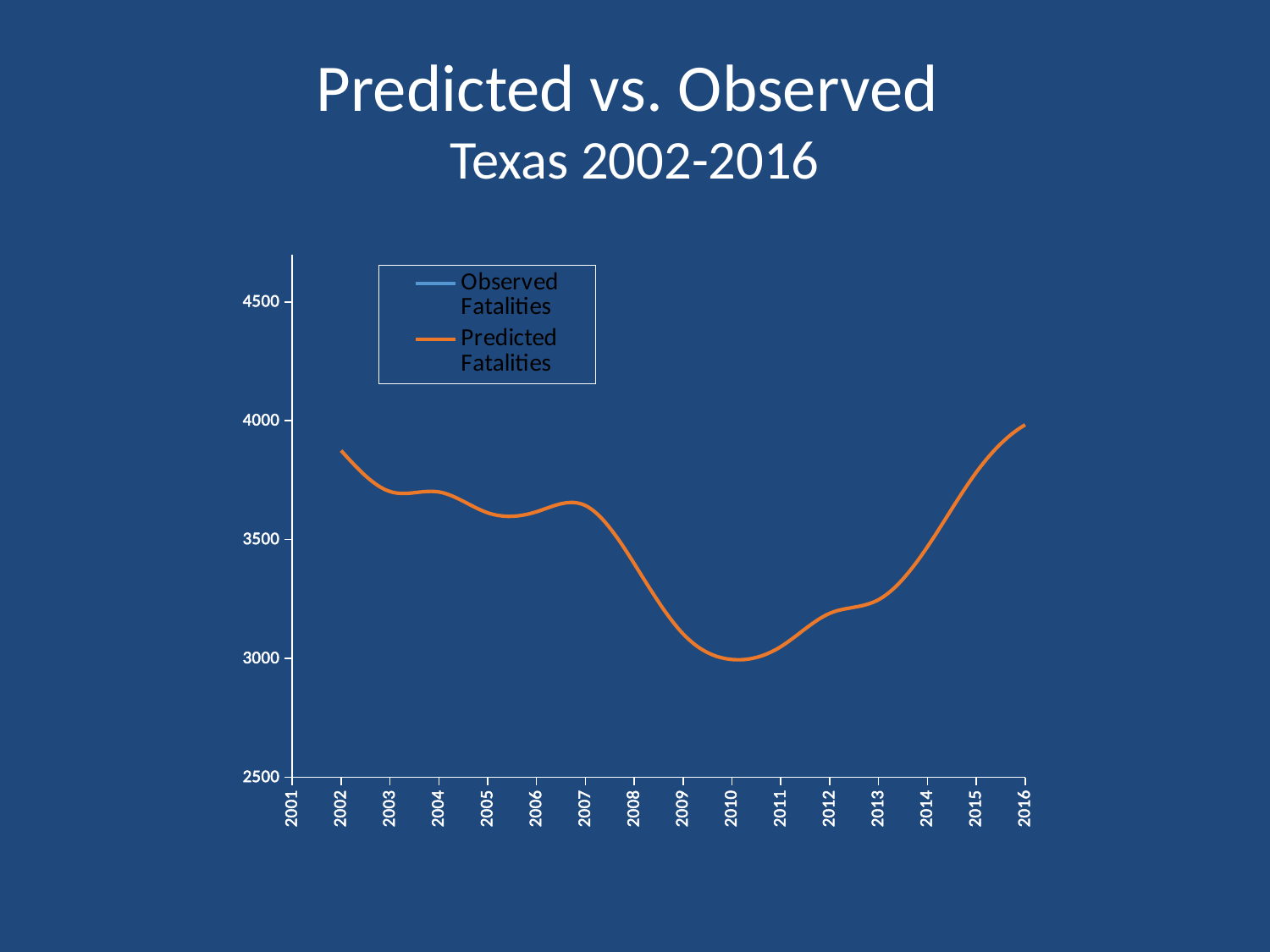
Does the Predicted Fatalities line rise or fall between 2010 and 2016? rise Which year has the higher Predicted Fatalities value, 2004 or 2012? 2004 Is the Predicted Fatalities value for 2002 greater or less than 3500? greater Is the Predicted Fatalities value for 2012 greater or less than 3000? greater What are the two series named in the legend? Observed Fatalities and Predicted Fatalities Is the Predicted Fatalities value for 2005 greater or less than 3500? greater In which year does the Predicted Fatalities line reach its lowest point? 2010 How many series does the legend list? 2 What is the title of the chart on the slide? Predicted vs. Observed Texas 2002-2016 What kind of chart is shown on the slide? line chart In which year does the Predicted Fatalities line reach its highest point? 2016